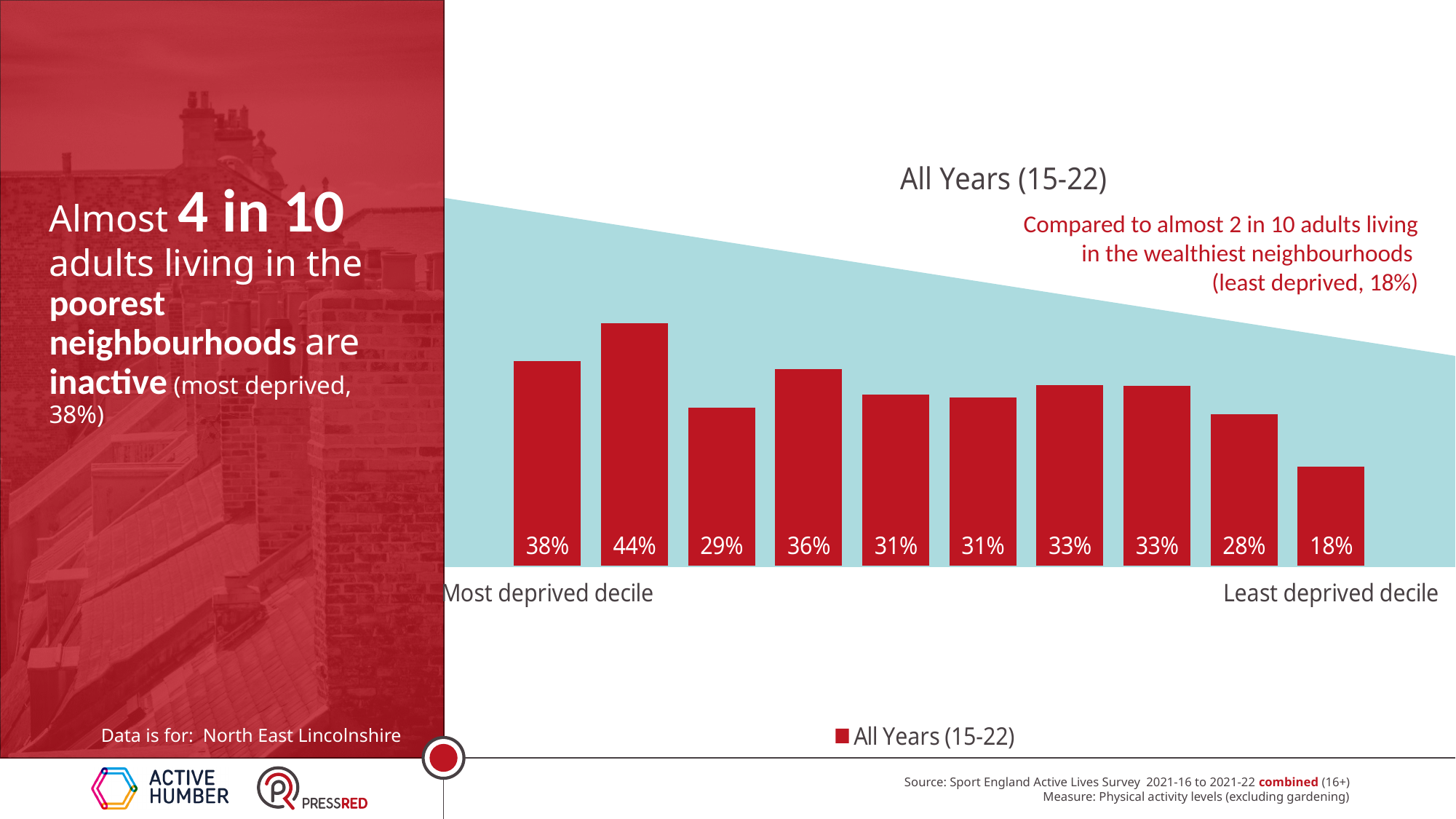
What is the highest value shown by any bar in the chart? 44% What is the lowest value shown in the chart? 18% What is the value for the Most deprived decile? 38% What is the label of the series shown in the legend? All Years (15-22) How many bars are plotted in the chart? 10 What kind of chart is shown on the slide? Bar chart What is the difference between the value for the Most deprived decile and the Least deprived decile? 20 percentage points What is the title of the chart? All Years (15-22) Which is larger, the value for the Most deprived decile or the Least deprived decile? Most deprived decile How many series does the legend list? 1 Which decile has the lowest value in the chart? Least deprived decile What is the value for the Least deprived decile? 18%